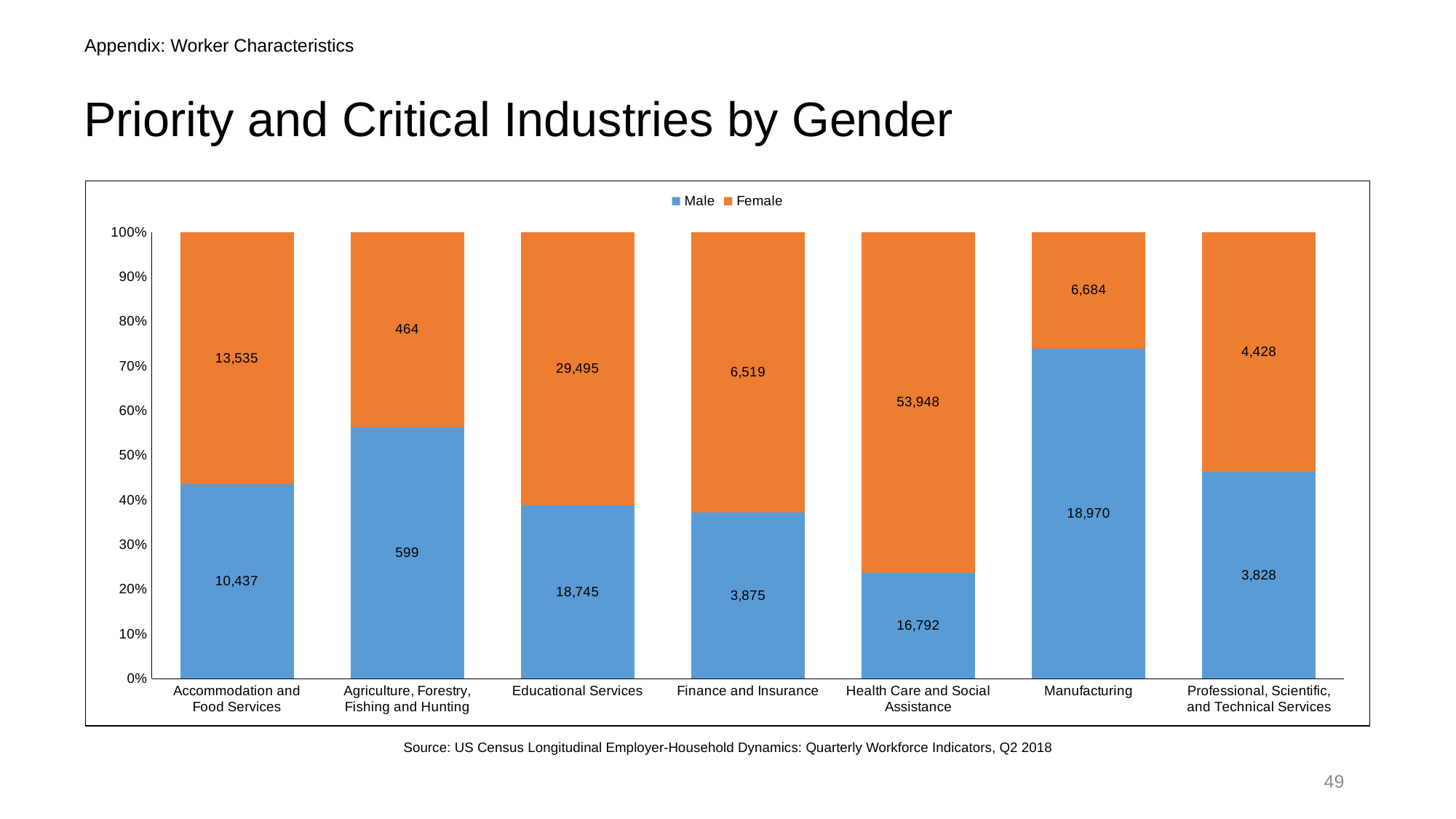
Is the Male share of the Manufacturing bar greater or less than 70%? greater Which is larger for Manufacturing, the Male value or the Female value? Male What is the combined Male and Female total for Accommodation and Food Services? 23,972 What is the Male value for Educational Services? 18,745 What kind of chart is shown? Stacked bar chart Which industry has the lowest Male value? Agriculture, Forestry, Fishing and Hunting What is the Female value for Health Care and Social Assistance? 53,948 What is the Female value for Agriculture, Forestry, Fishing and Hunting? 464 How many industries are shown on the x axis? 7 What is the difference between the Female and Male values for Finance and Insurance? 2,644 How many series does the legend list? 2 Which industry has the highest Female value? Health Care and Social Assistance